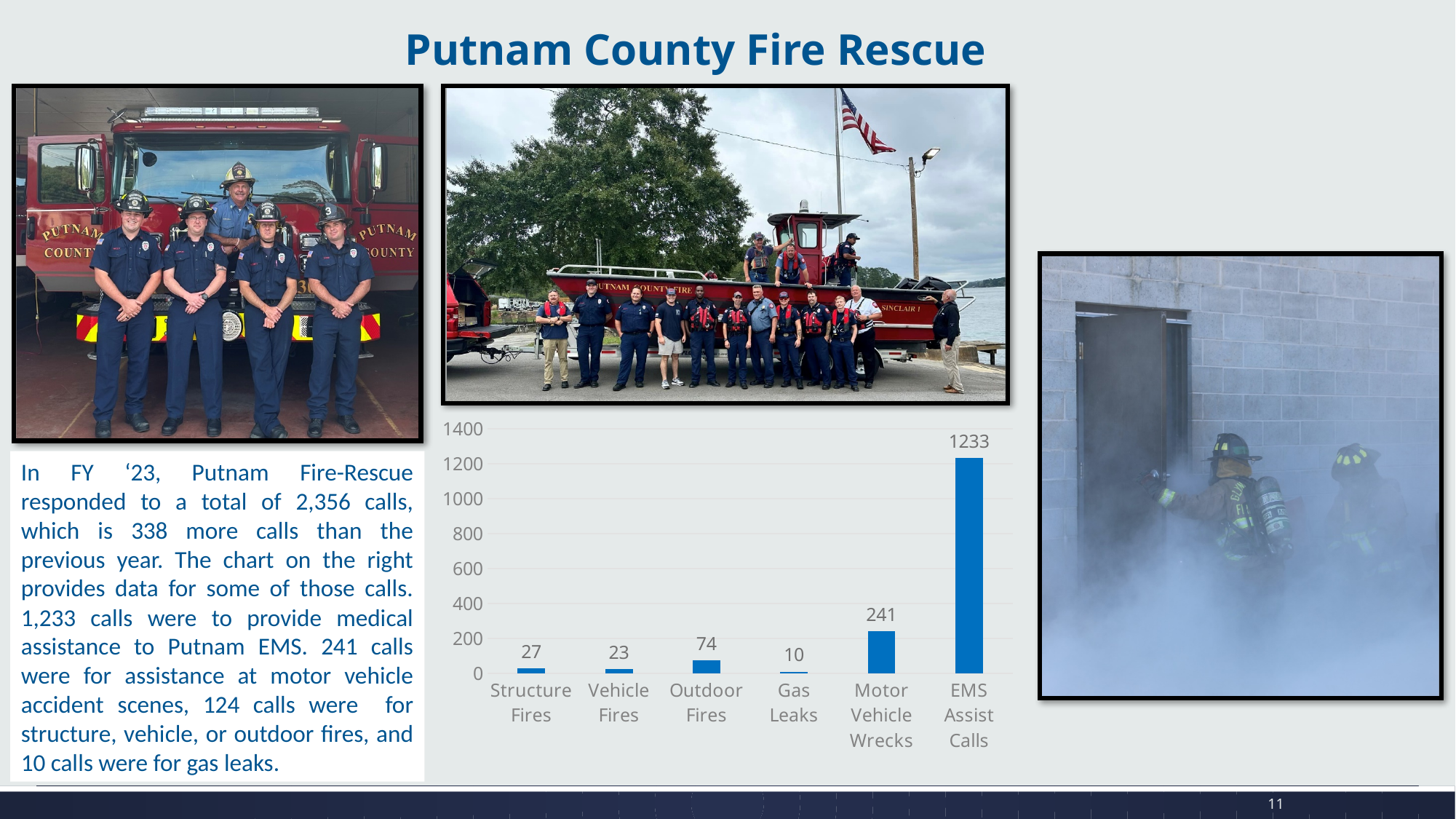
What kind of chart is shown on the slide? bar chart What is the value for EMS Assist Calls? 1233 Which category has the highest value? EMS Assist Calls What is the value for Gas Leaks? 10 What is the value for Motor Vehicle Wrecks? 241 Which category has the lowest value? Gas Leaks How many categories are shown on the chart? 6 Which is larger, Outdoor Fires or Structure Fires? Outdoor Fires What is the difference between EMS Assist Calls and Motor Vehicle Wrecks? 992 Is the value for Motor Vehicle Wrecks greater or less than 400? less What is the difference between Structure Fires and Vehicle Fires? 4 What is the value for Outdoor Fires? 74